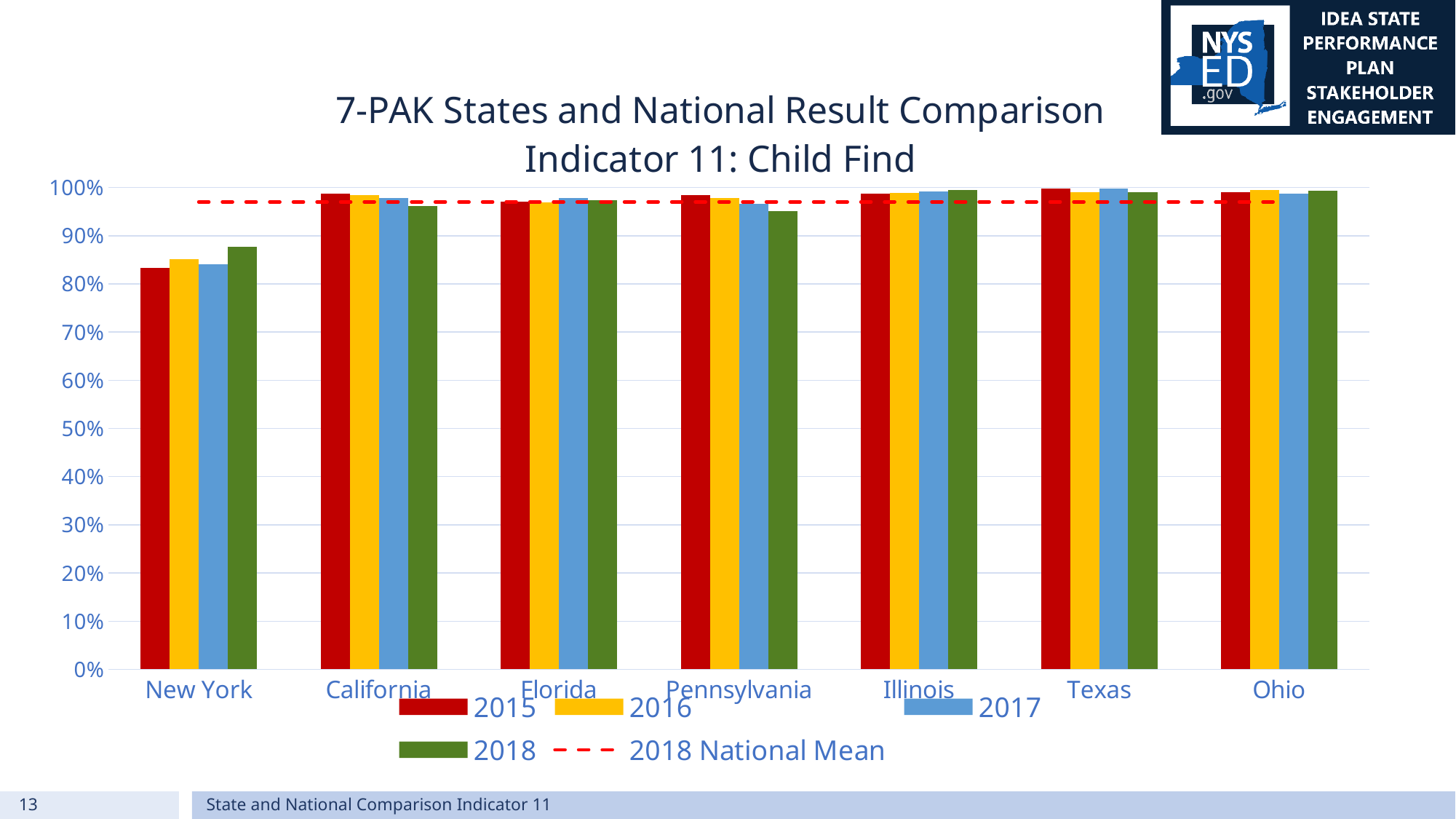
What kind of chart is shown on the slide? bar chart For New York, which is larger: the 2015 value or the 2018 value? 2018 Which state has the lowest value for 2018? New York Is the 2016 value for New York greater or less than 80%? greater How many entries does the chart's legend list? 5 Is the 2015 value for New York greater or less than 90%? less How many states are shown on the x axis of the chart? 7 Which state has the lowest value for 2015? New York For 2018, which is larger: the value for Pennsylvania or the value for Texas? Texas What is the title of the chart? 7-PAK States and National Result Comparison Indicator 11: Child Find Is the 2018 value for Pennsylvania greater or less than 90%? greater